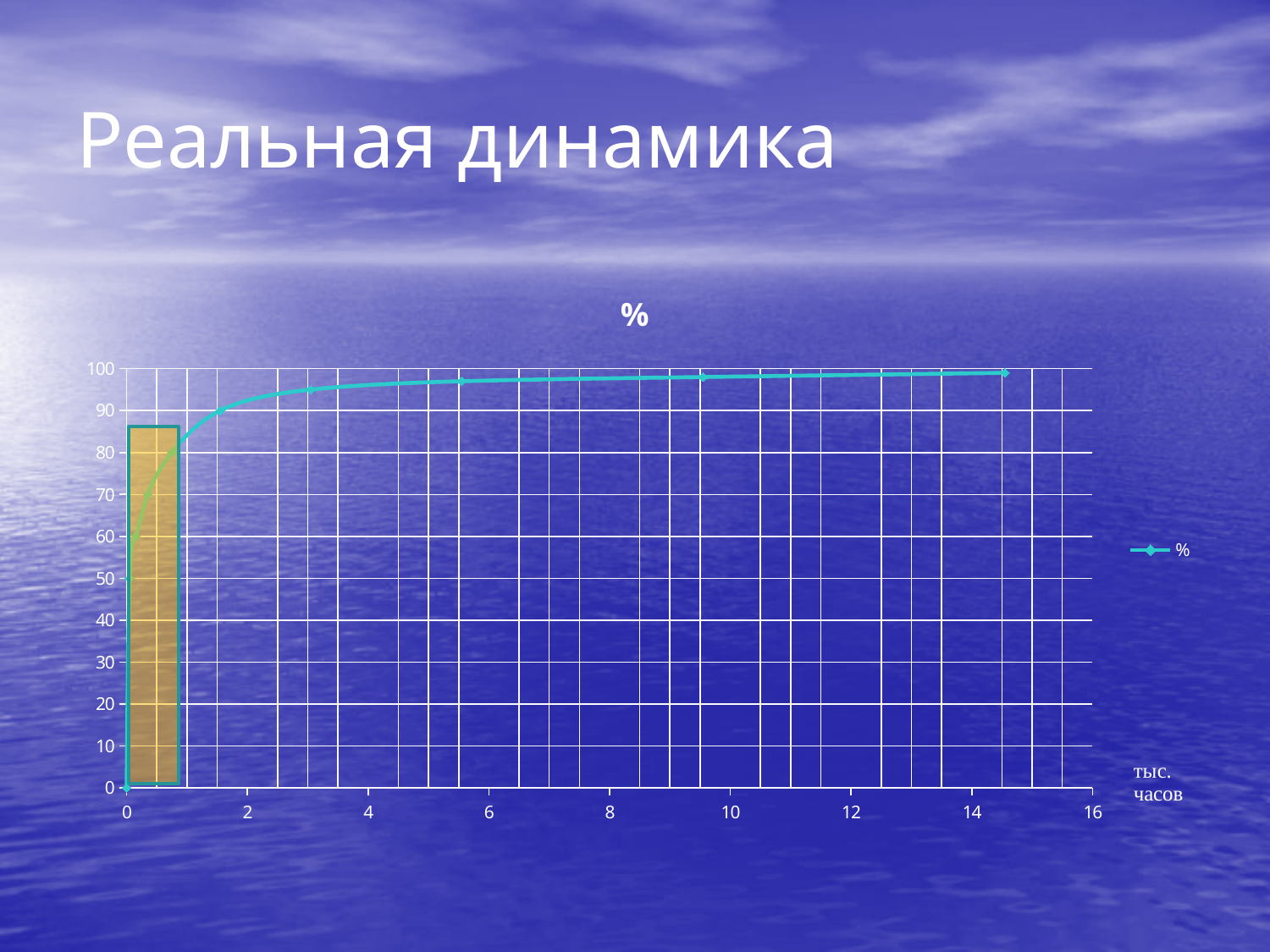
What is the label of the series in the legend? % Is the value of the line at x = 14 greater or less than 90? greater Do the values rise or fall as the x axis increases from 0 to 16? rise Is the value of the line at x = 0 greater or less than 70? less What is the title of the chart? % Is the value of the line at x = 8 greater or less than 100? less How many series does the legend list? 1 What is the maximum value shown on the y axis? 100 What kind of chart is shown on the slide? line chart